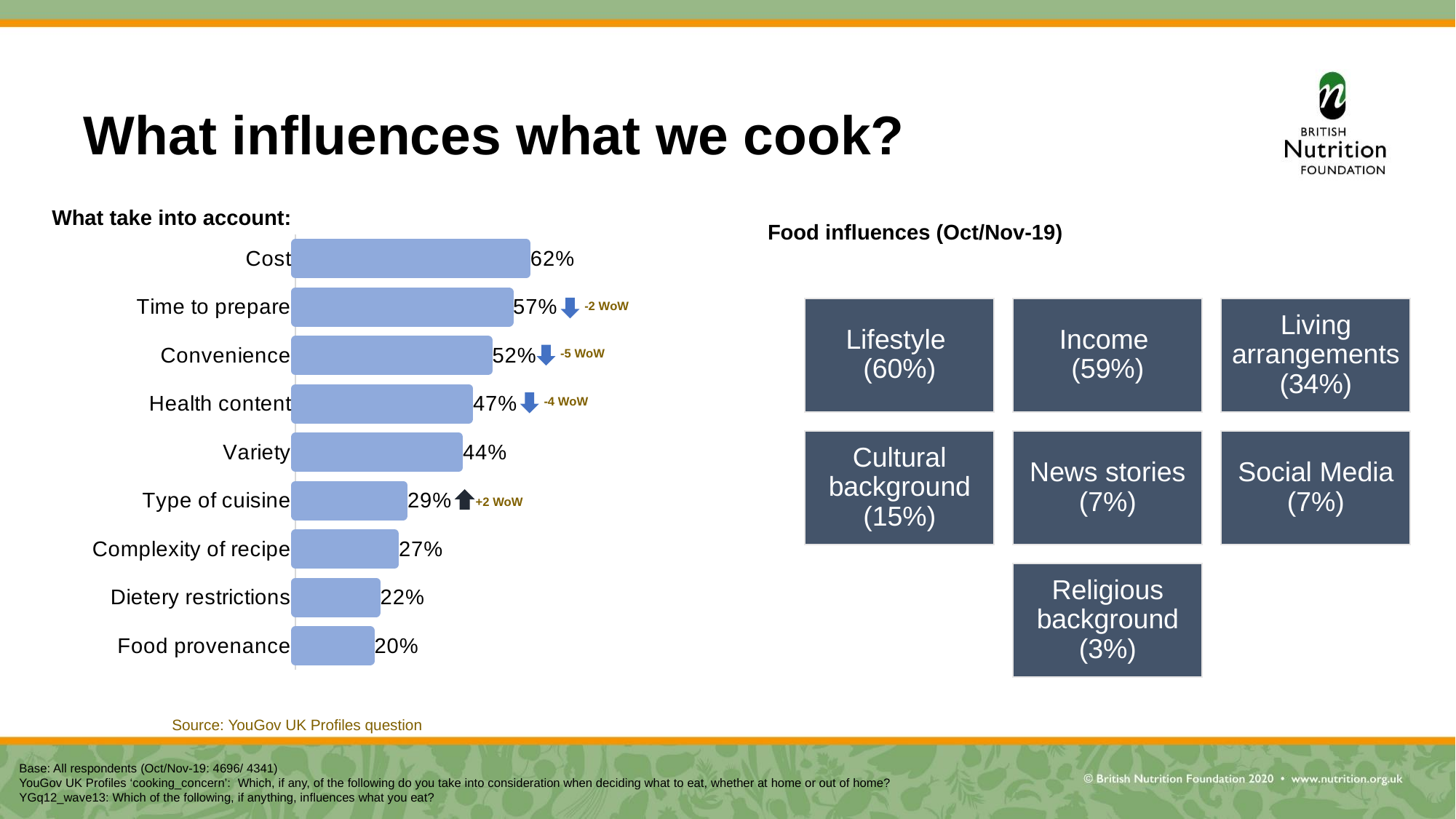
In the 'What take into account' chart, which category has the lowest value? Food provenance In the 'What take into account' chart, which category has the highest value? Cost How many categories are shown in the 'What take into account' chart? 9 In the 'What take into account' chart, what is the difference between the values for Variety and Type of cuisine? 15% In the 'What take into account' chart, what is the value for Complexity of recipe? 27% In the 'What take into account' chart, which is larger: Convenience or Variety? Convenience In the 'What take into account' chart, what week-on-week change is annotated next to Convenience? -5 WoW What type of chart is the 'What take into account' chart? Bar chart In the 'What take into account' chart, what is the value for Health content? 47% In the 'What take into account' chart, what is the value for Food provenance? 20% In the 'What take into account' chart, what is the difference between the values for Cost and Time to prepare? 5% In the 'What take into account' chart, what is the value for Cost? 62%